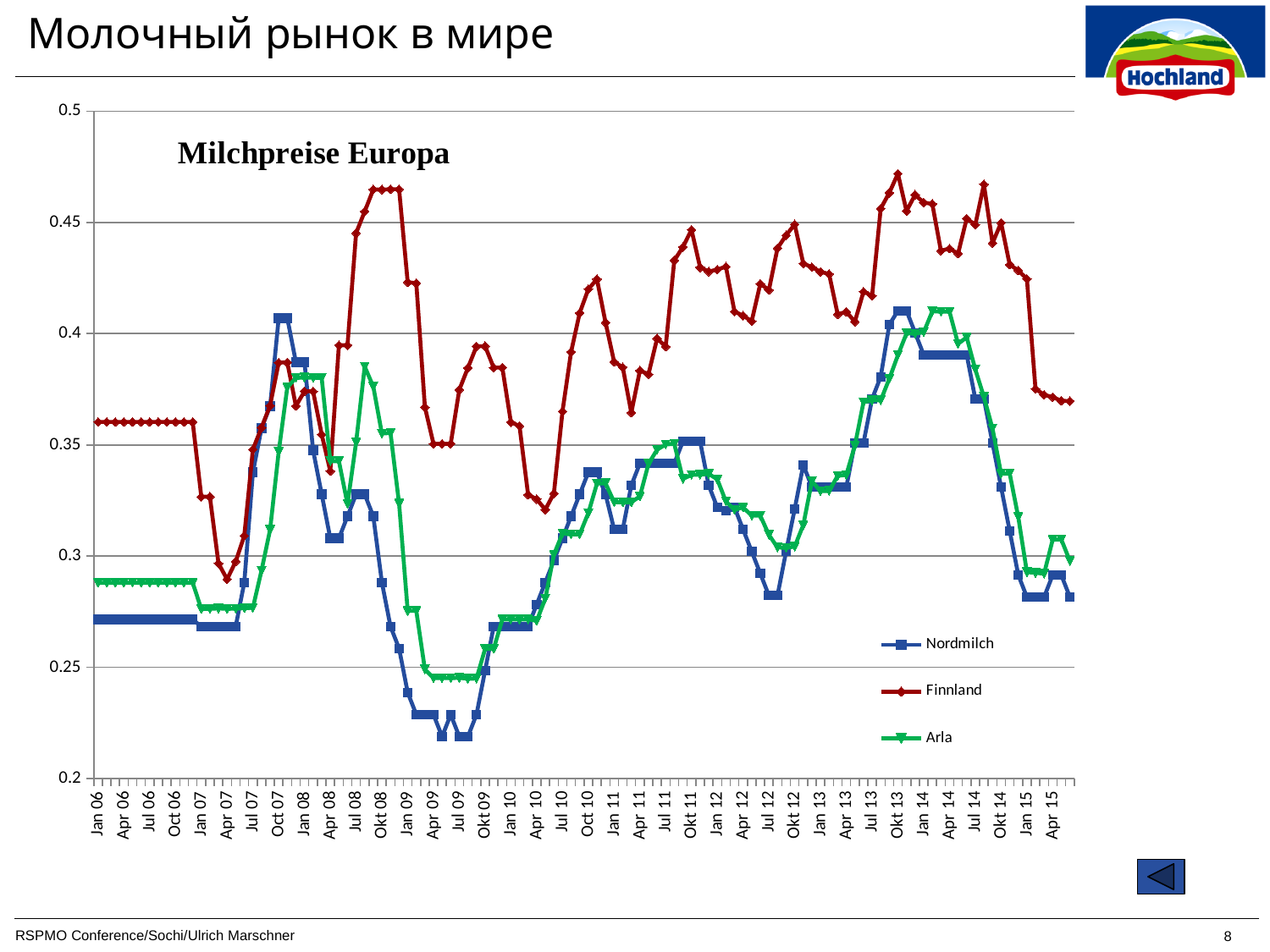
What is the title of the chart? Milchpreise Europa How many series does the legend of the chart list? 3 Is the value for Nordmilch in Jul 09 greater or less than 0.25? less What kind of chart is shown on the slide? line chart Which series has the higher value in Okt 13, Finnland or Nordmilch? Finnland Is the value for Finnland in Jan 06 greater or less than 0.35? greater Which colour is used for the Finnland series in the chart? red Which series has the higher value in Jan 06, Arla or Nordmilch? Arla Which series reaches the highest value anywhere in the chart? Finnland Is the value for Finnland in Okt 08 greater or less than 0.45? greater Does the Finnland series rise or fall between Jan 15 and Apr 15? fall